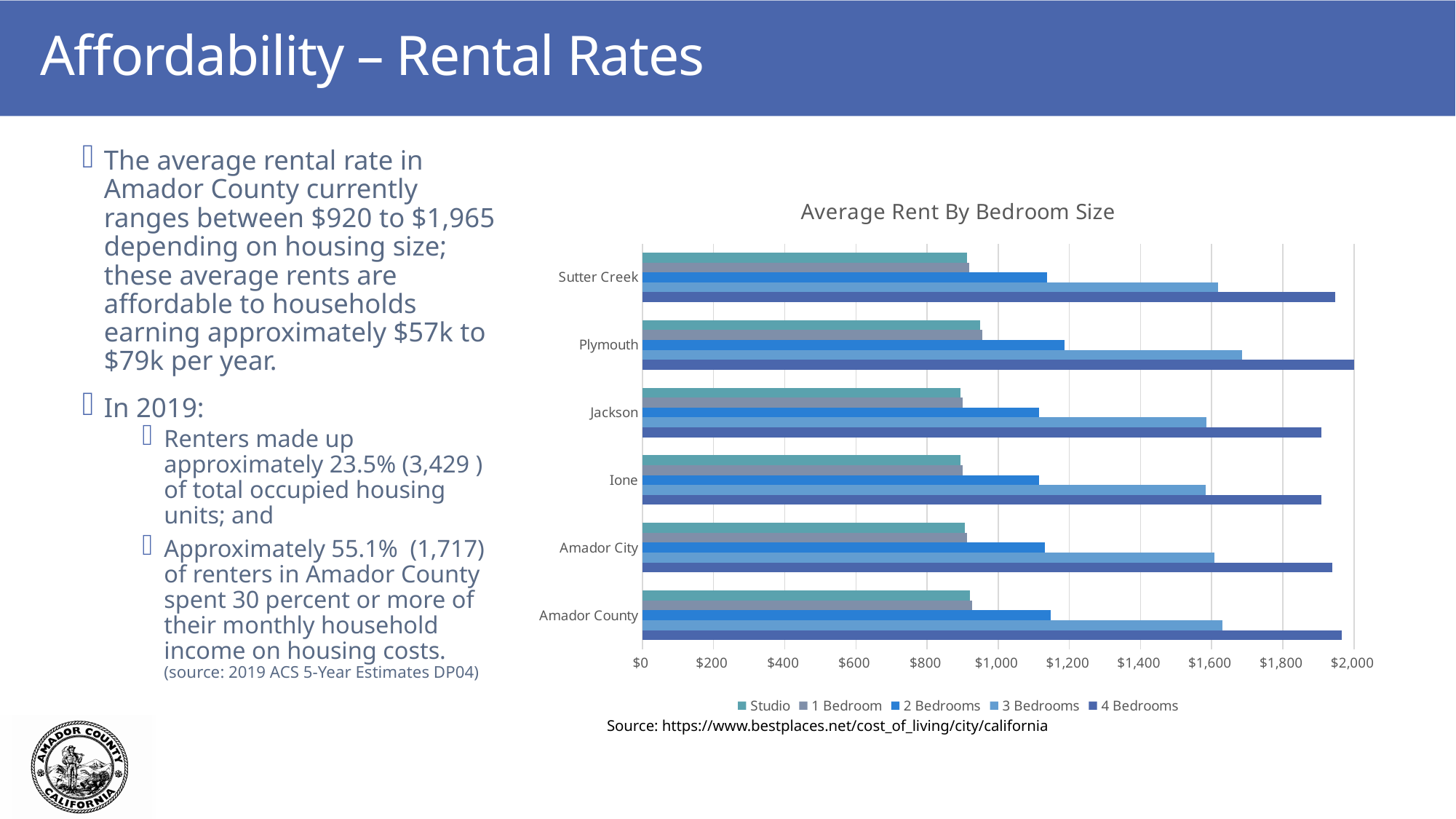
Which location has the highest 3 Bedrooms average rent? Plymouth What is the title of the chart? Average Rent By Bedroom Size Is the 3 Bedrooms value for Ione greater or less than $1,400? greater How many locations (categories) are shown on the chart? 6 Is the 4 Bedrooms value for Sutter Creek greater or less than $1,800? greater Which series is shown in the darkest blue colour in the legend? 4 Bedrooms Is the Studio value for Jackson greater or less than $800? greater Which is larger, the 2 Bedrooms value for Plymouth or the 2 Bedrooms value for Jackson? Plymouth How many series does the chart legend list? 5 What type of chart is shown on the slide? Bar chart